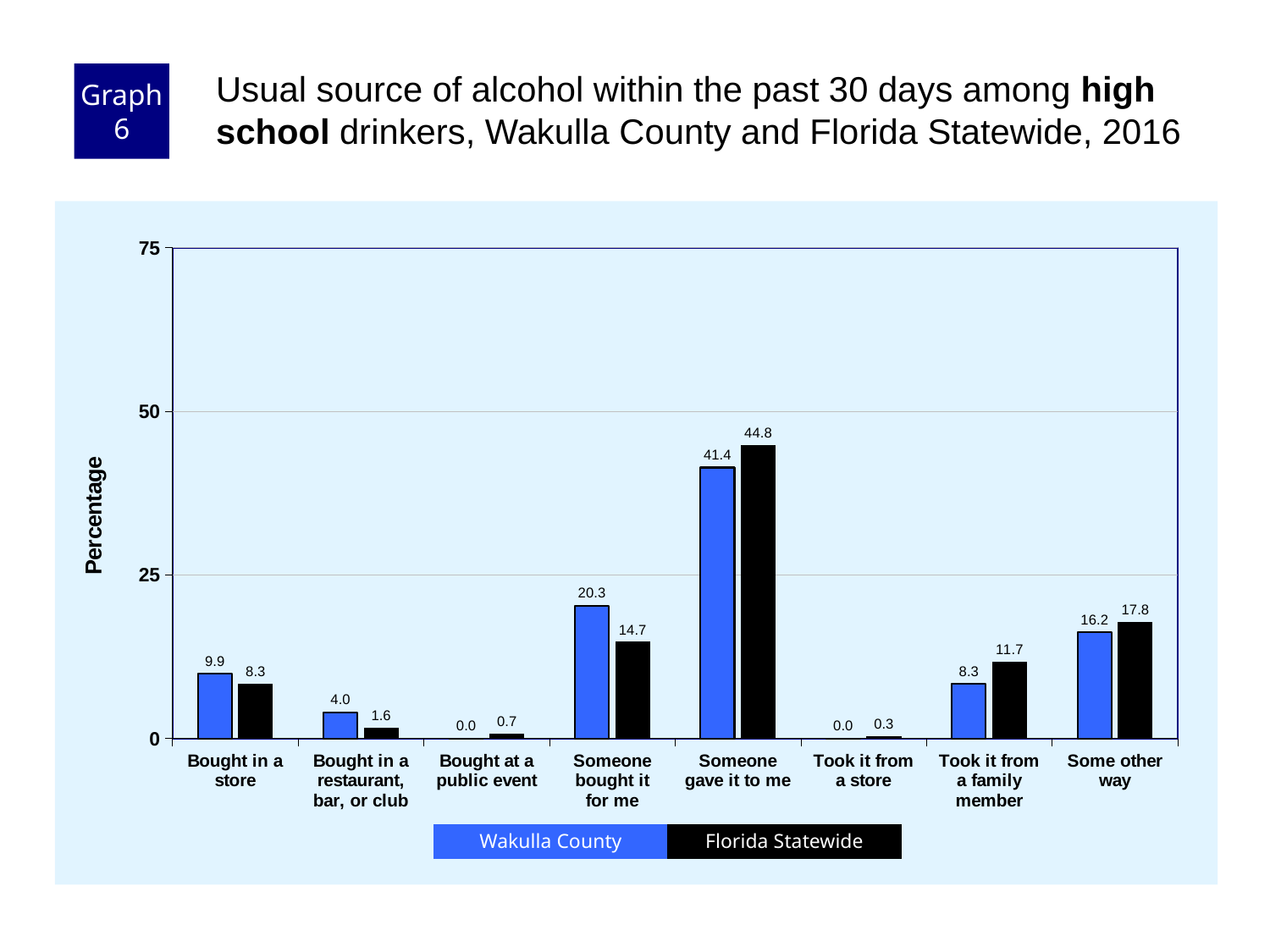
What kind of chart is shown on the slide? Bar chart How many series does the legend list? 2 What is the Wakulla County value for "Someone gave it to me"? 41.4 What is the Florida Statewide value for "Took it from a family member"? 11.7 Is the Wakulla County value for "Someone gave it to me" greater or less than 50? less Which category has the lowest Florida Statewide value? Took it from a store Which category has the highest Florida Statewide value? Someone gave it to me For "Some other way", which is larger: Wakulla County or Florida Statewide? Florida Statewide What is the difference between the Florida Statewide and Wakulla County values for "Someone gave it to me"? 3.4 What is the Wakulla County value for "Bought in a restaurant, bar, or club"? 4.0 How many categories are shown on the x axis? 8 What is the difference between the Wakulla County and Florida Statewide values for "Someone bought it for me"? 5.6